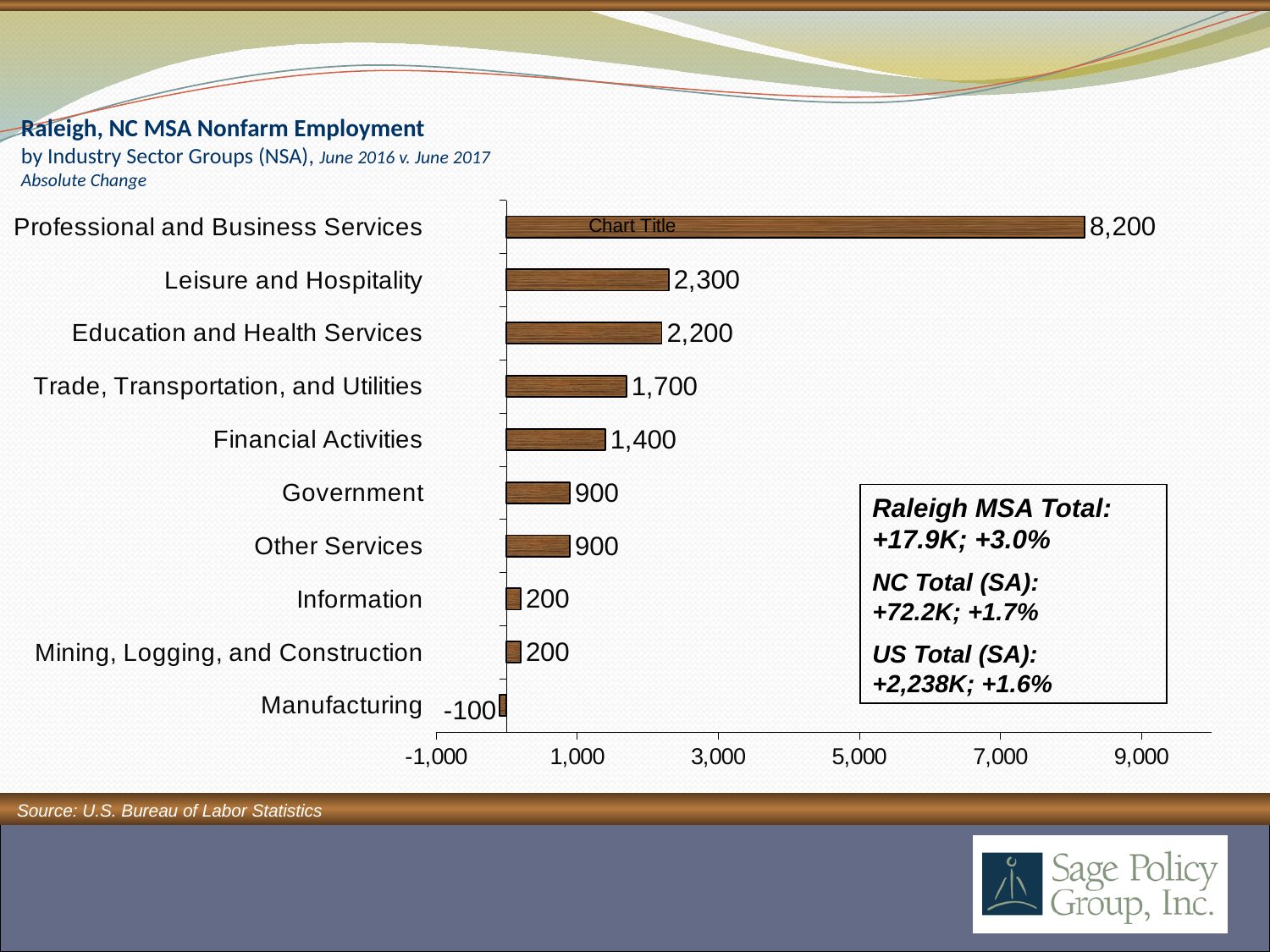
What is the absolute change in employment for Professional and Business Services? 8,200 What is the value shown for Financial Activities? 1,400 What is the value shown for Leisure and Hospitality? 2,300 Which industry sector group has the lowest absolute change? Manufacturing What is the difference between the values for Professional and Business Services and Leisure and Hospitality? 5,900 What is the source cited for the chart data? U.S. Bureau of Labor Statistics How many industry sector groups are shown in the chart? 10 Which industry sector group has the highest absolute change? Professional and Business Services What is the difference between the values for Education and Health Services and Trade, Transportation, and Utilities? 500 What kind of chart is shown on the slide? Bar chart What is the value shown for Manufacturing? -100 Which is larger, the value for Government or the value for Information? Government